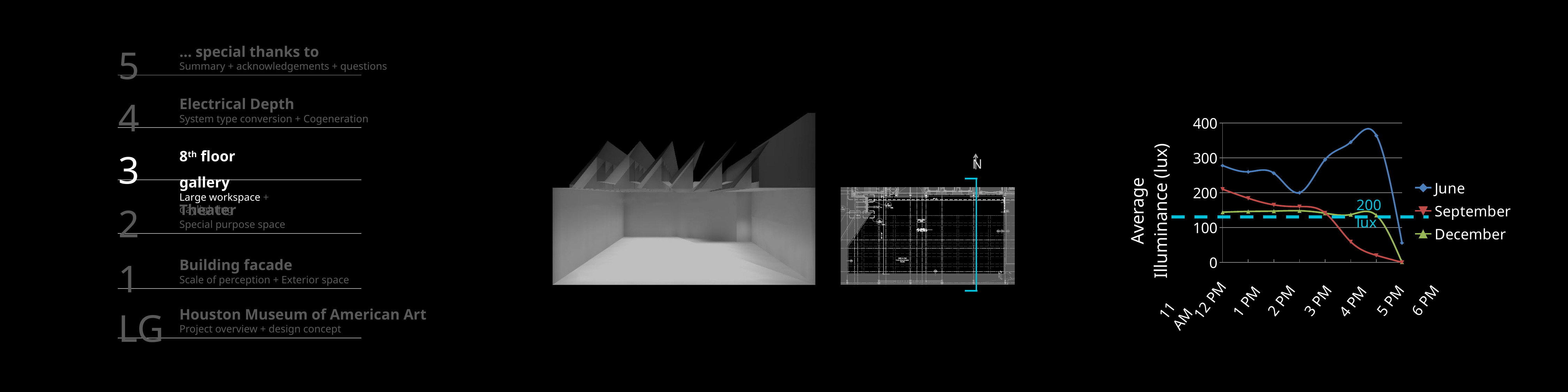
Is the value for December at 11 AM greater or less than 200? less At which time does the June series reach its highest value? 5 PM How many series does the chart legend list? 3 What kind of chart is shown on the slide? line chart Does the September series rise or fall from 11 AM to 6 PM? fall Is the value for June at 5 PM greater or less than 300? greater How many time points are plotted along the x axis of the chart? 8 What is the title of the chart's vertical axis? Average Illuminance (lux) Which series has the higher value at 4 PM, June or December? June Which series are listed in the chart legend? June, September, December Is the value for September at 6 PM greater or less than 100? less At which time does the June series reach its lowest value? 6 PM